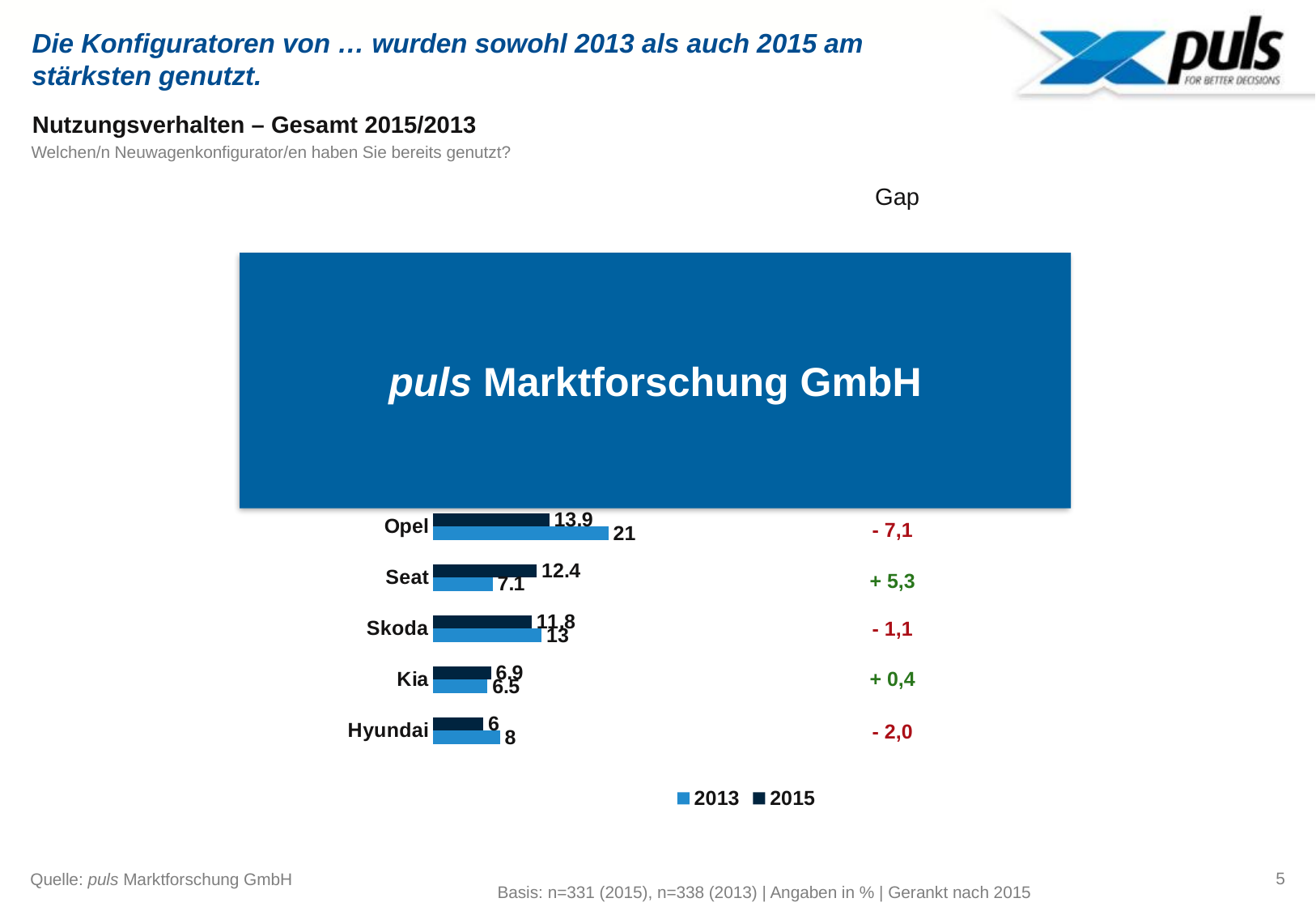
What is the value for Opel in 2015? 13.9 For Kia, which year has the larger value, 2013 or 2015? 2015 What is the value for Hyundai in 2013? 8 How many series does the legend list? 2 What is the difference between the 2015 and 2013 values for Seat? 5.3 What is the value for Opel in 2013? 21 What is the difference between the 2013 and 2015 values for Hyundai? 2 What is the value for Skoda in 2013? 13 For Skoda, which year has the larger value, 2013 or 2015? 2013 What is the value for Seat in 2015? 12.4 What is the value for Kia in 2015? 6.9 What kind of chart is shown on the slide? bar chart